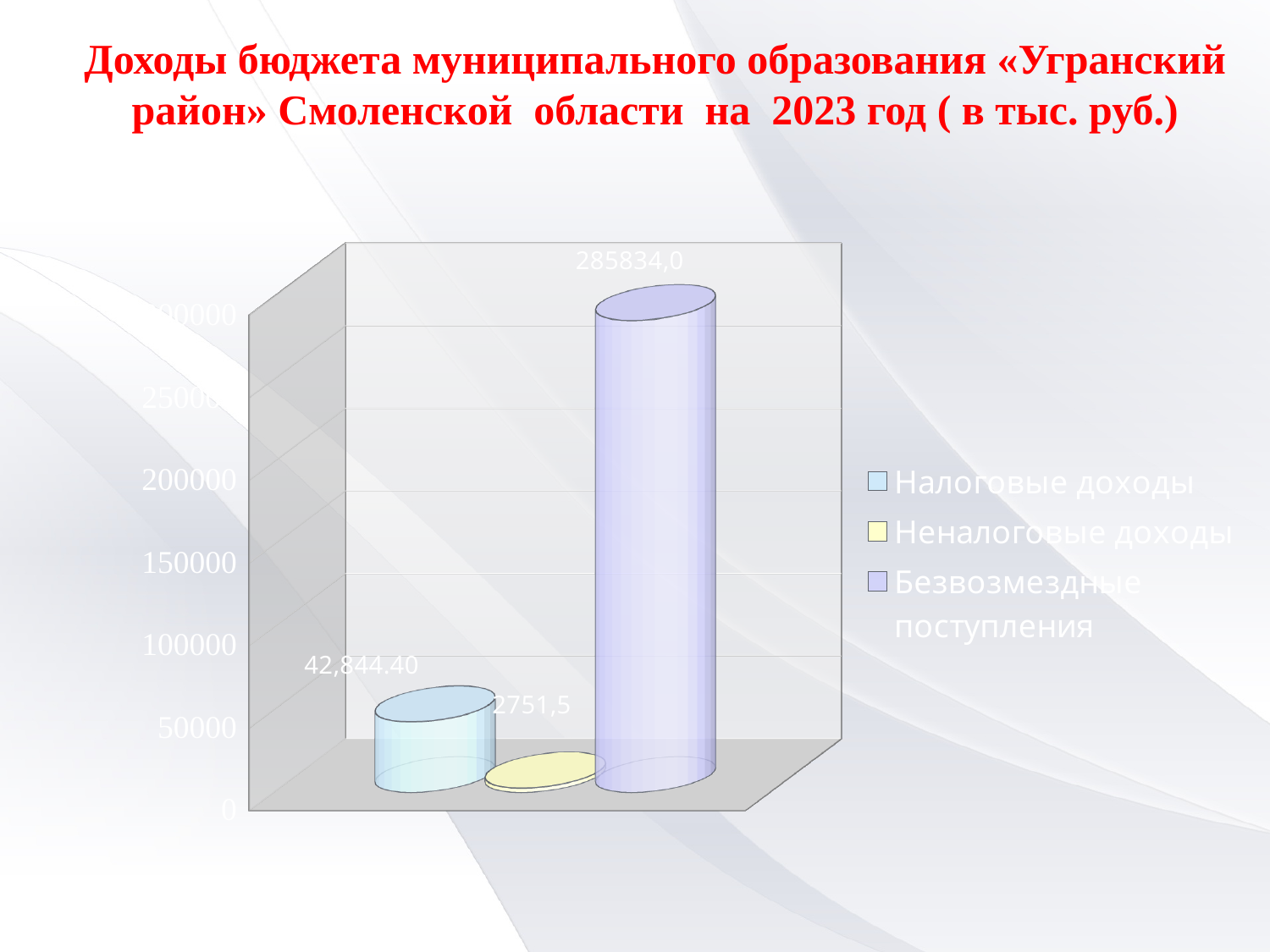
What is the value shown for Неналоговые доходы? 2751,5 Is the value for Налоговые доходы greater or less than 50000? less What is the value shown for Безвозмездные поступления? 285834,0 Which category has the lowest value? Неналоговые доходы Which category has the highest value? Безвозмездные поступления Which is larger, Налоговые доходы or Неналоговые доходы? Налоговые доходы Is the value for Безвозмездные поступления greater or less than 250000? greater How many series does the legend list? 3 How many bars are plotted on the chart? 3 What year does the chart title say the budget revenues are for? 2023 What is the value shown for Налоговые доходы? 42,844.40 What kind of chart is shown on the slide? bar chart